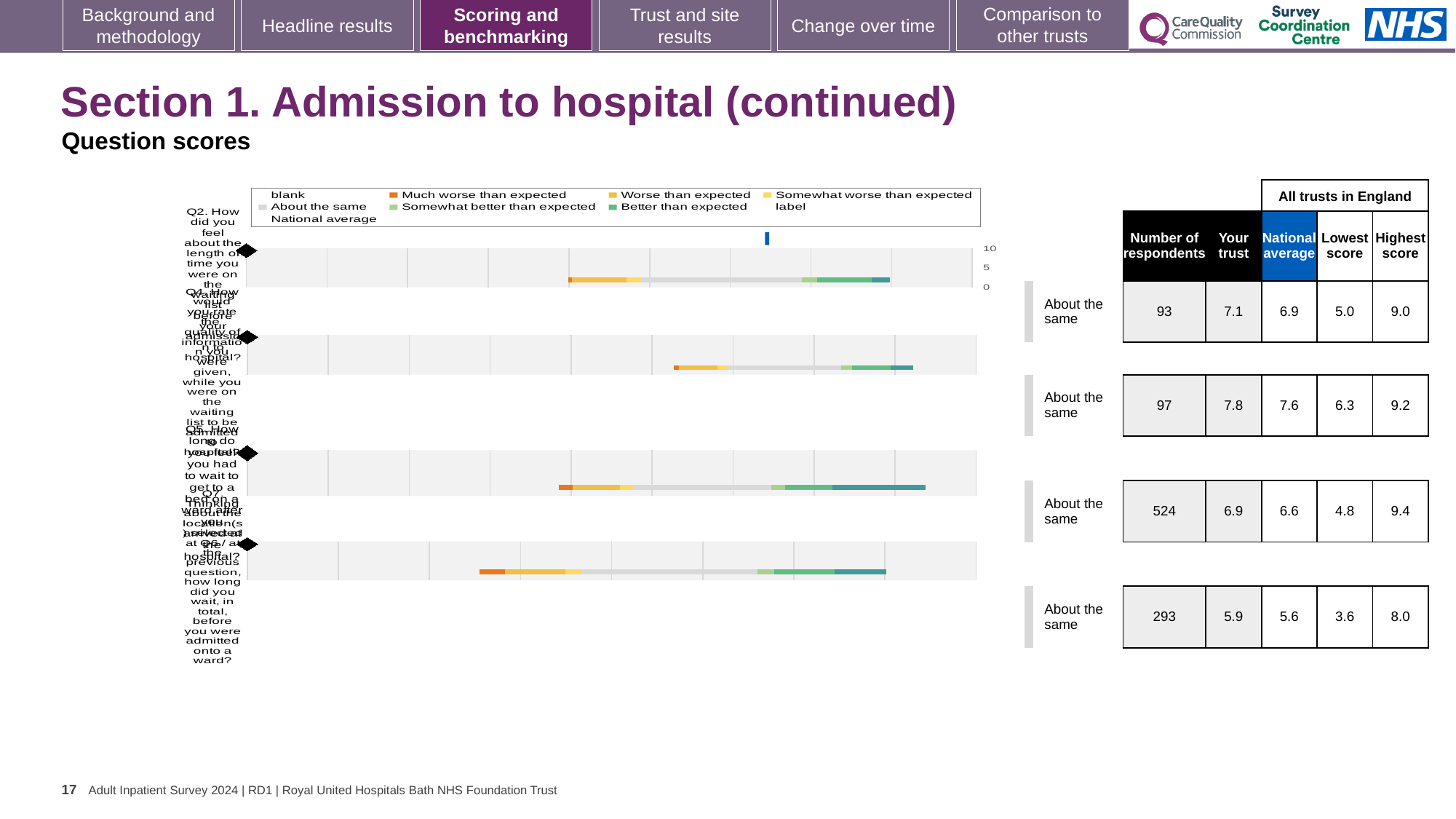
In the table, what is the national average for the first row (93 respondents)? 6.9 In the table, what is the 'Your trust' score for the row with 524 respondents? 6.9 Which row has the highest 'Your trust' score in the table? the second row (97 respondents), 7.8 In the first row (93 respondents), is the 'Your trust' score or the national average larger? Your trust (7.1) In the table, what is the highest score for the second row (97 respondents)? 9.2 Which row has the lowest 'Your trust' score in the table? the fourth row (293 respondents), 5.9 What kind of chart is shown on the slide? bar chart What benchmark category is shown for every question row on the slide? About the same How many entries does the chart legend list? 9 How many question rows are plotted in the chart? 4 In the table, what is the lowest score for the row with 524 respondents? 4.8 For the row with 293 respondents, what is the difference between the 'Your trust' score and the national average? 0.3